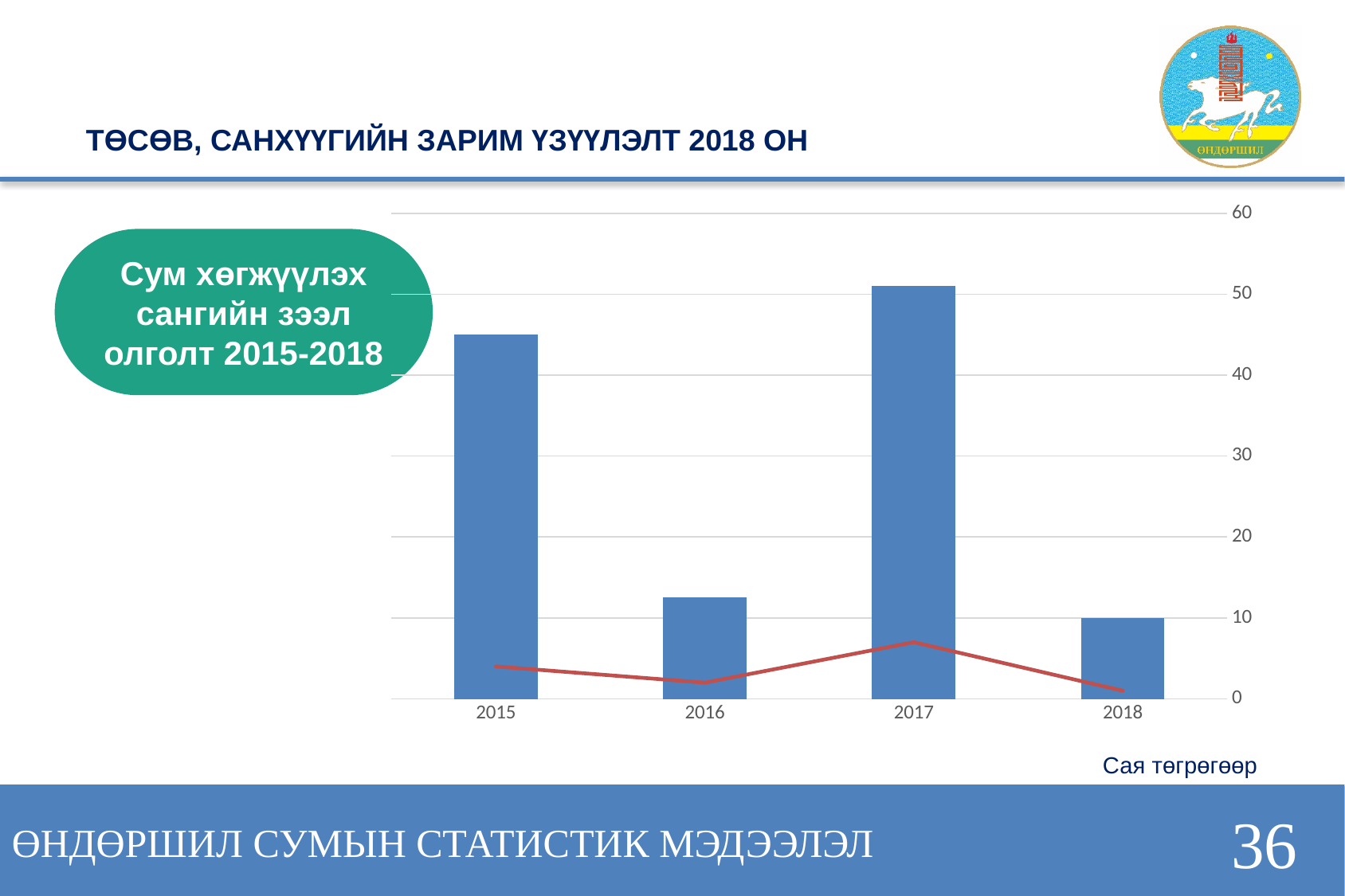
Which year has the tallest bar in the chart? 2017 In which year does the red line reach its highest point? 2017 Is the bar value for 2015 greater or less than 40? greater How many years are shown on the x axis of the chart? 4 Is the bar value for 2016 greater or less than 20? less What kind of chart is shown on the slide? combination bar and line chart Is the bar value for 2018 greater or less than 20? less What is the title shown in the green bubble next to the chart? Сум хөгжүүлэх сангийн зээл олголт 2015-2018 Which bar is taller, 2016 or 2018? 2016 Which bar is taller, 2015 or 2017? 2017 What unit is stated below the chart? Сая төгрөгөөр Which year has the shortest bar in the chart? 2018